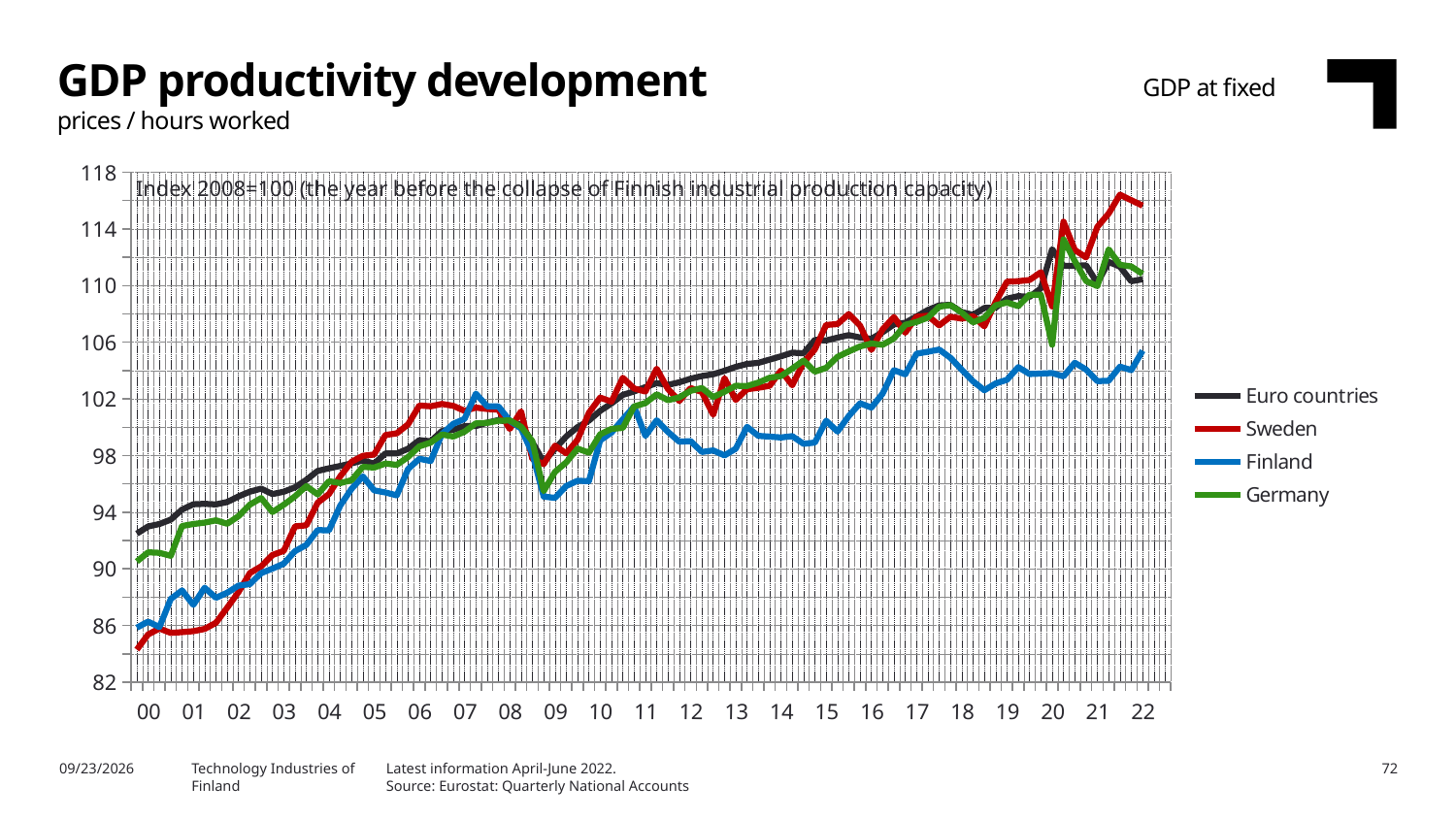
Which series are listed in the legend? Euro countries, Sweden, Finland, Germany How many series does the legend list? 4 Which series has the highest value at the end of the chart (22)? Sweden What kind of chart is shown on the slide? line chart Is the value for Germany at its 2009 low point greater or less than 98? less Is the value for Sweden at 22 greater or less than 114? greater Overall, does the Finland series rise or fall from 00 to 22? rise Which year is used as the index base (=100) in the chart? 2008 At 00, which is larger: the value for Euro countries or the value for Finland? Euro countries Is the value for Finland at 22 greater or less than 110? less Which series has the lowest value at the end of the chart (22)? Finland